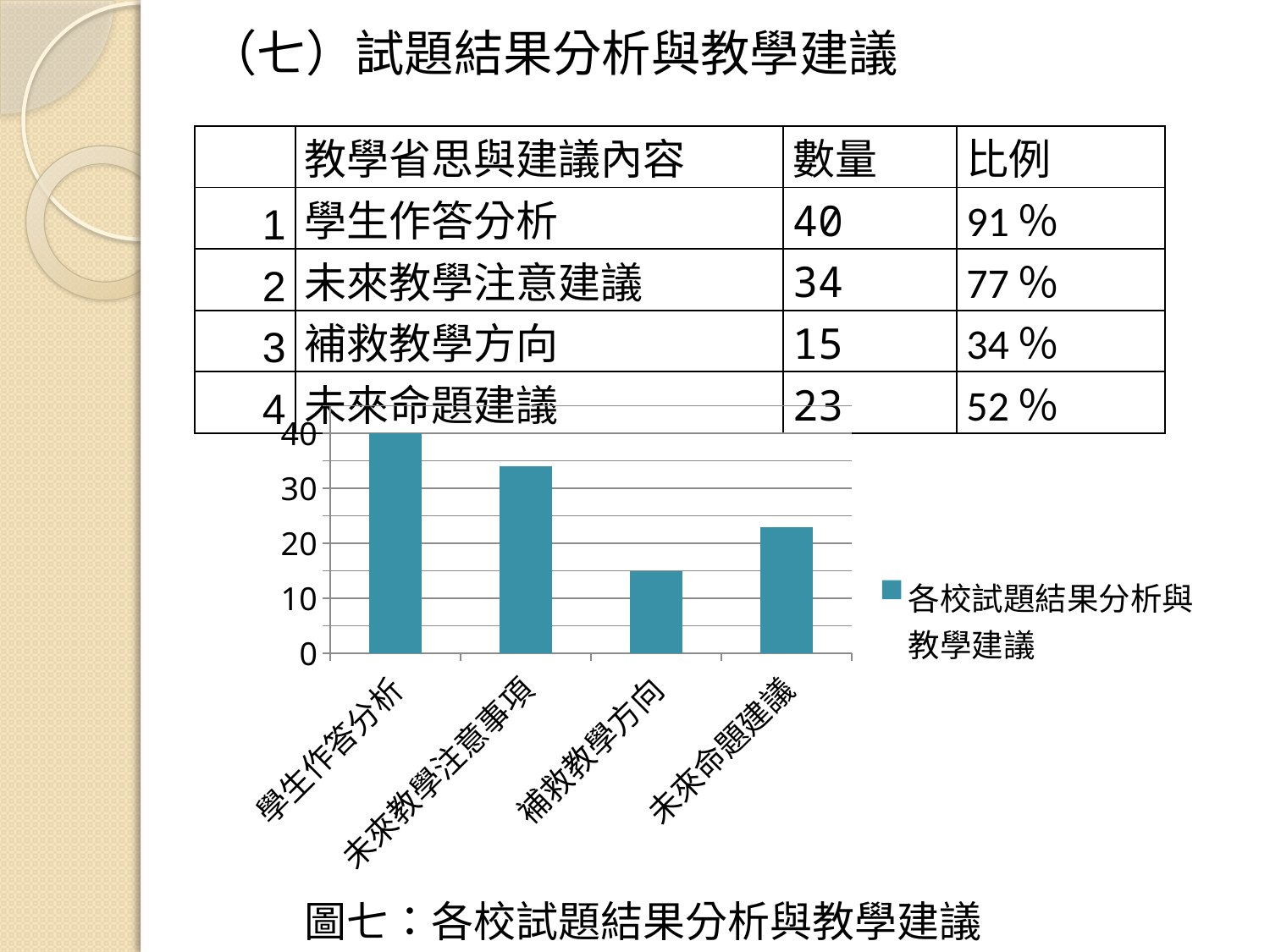
Is the value for 未來命題建議 greater or less than 20? greater What kind of chart is shown on the slide? bar chart Which category has the highest bar in the chart? 學生作答分析 Is the value for 補救教學方向 greater or less than 20? less How many categories are plotted on the x axis of the chart? 4 How many series does the chart legend list? 1 Is the value for 未來教學注意事項 greater or less than 30? greater What is the caption given below the chart? 圖七：各校試題結果分析與教學建議 What is the legend entry shown for the chart's series? 各校試題結果分析與教學建議 Which bar is taller, 未來教學注意事項 or 未來命題建議? 未來教學注意事項 What is the value of the bar for 學生作答分析? 40 Which category has the lowest bar in the chart? 補救教學方向